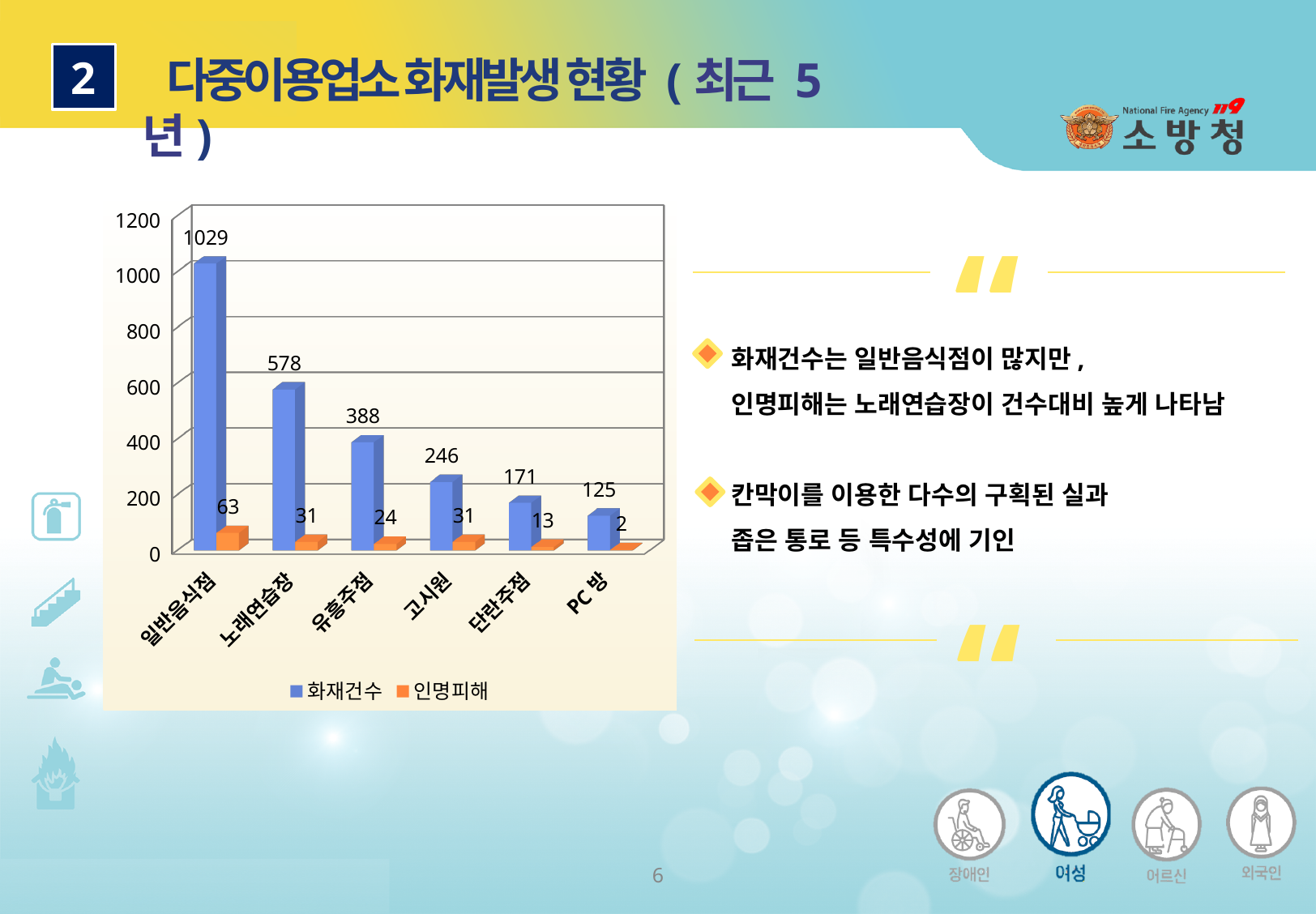
What is the difference in 화재건수 between 일반음식점 and 노래연습장? 451 What is the 화재건수 value for 고시원? 246 Which category has the lowest 인명피해? PC방 What is the 인명피해 value for 노래연습장? 31 What is the 화재건수 value for 일반음식점? 1029 Which category has the highest 화재건수? 일반음식점 What kind of chart is shown on the slide? Bar chart What is the 인명피해 value for PC방? 2 Which has a larger 인명피해 value, 유흥주점 or 단란주점? 유흥주점 How many categories are shown on the x axis? 6 Do the 화재건수 values rise or fall from left to right along the x axis? Fall How many series does the legend list? 2